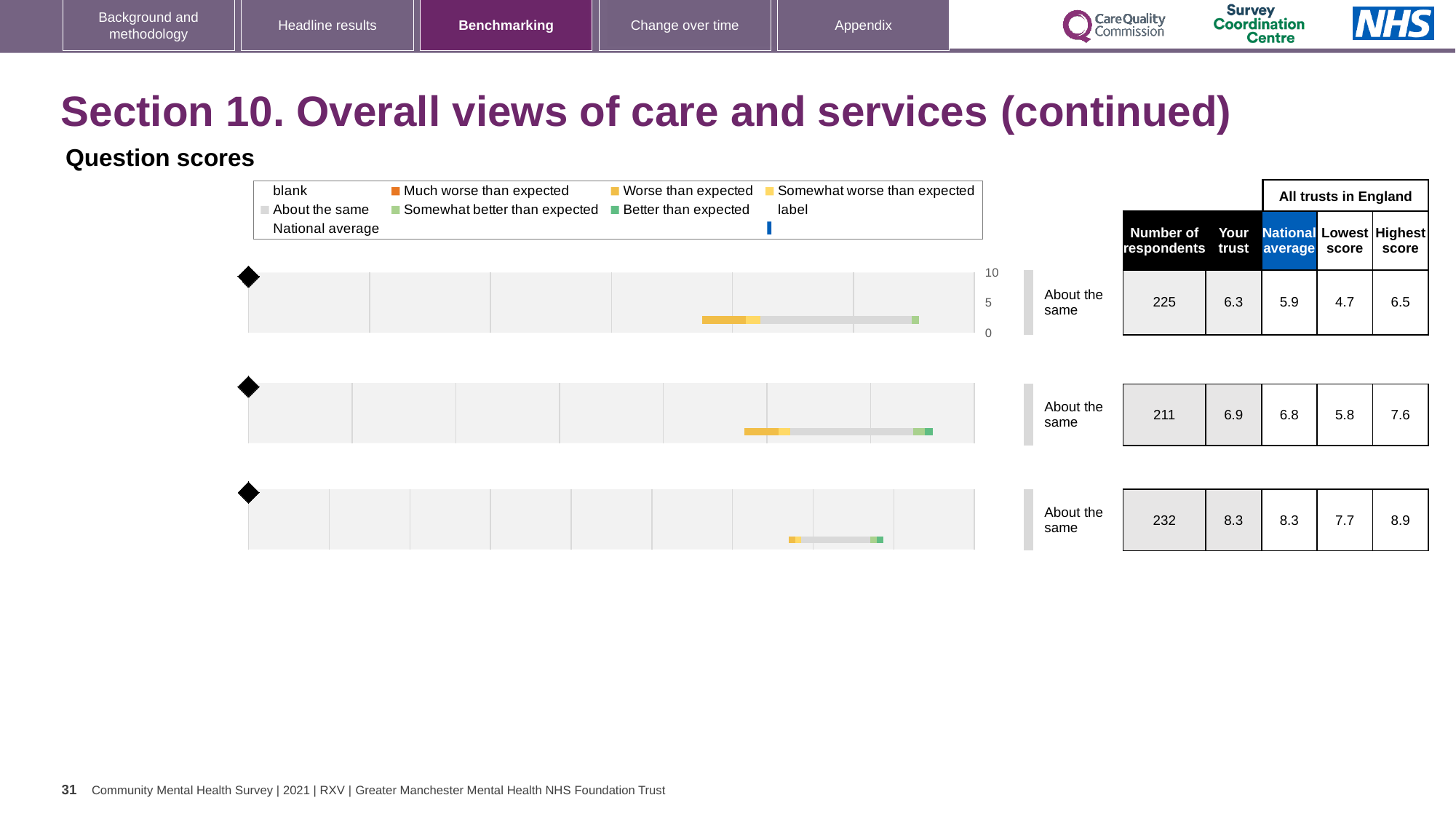
For the top chart, what is the number of respondents shown in the table? 225 For the middle chart, what is the lowest score among all trusts in England? 5.8 What benchmark category label is shown next to the bottom chart? About the same For the top chart, what is the difference between the highest score and the lowest score? 1.8 Which chart has the highest number of respondents: top, middle or bottom? bottom What is the maximum value shown on the score axis of the top chart? 10 For the bottom chart, what is the highest score among all trusts in England? 8.9 For the middle chart, which is larger: the 'Your trust' score or the national average? Your trust For the middle chart, what is the national average score? 6.8 How many benchmarking charts are shown on the slide? 3 What kind of chart is used for the question scores on this slide? bar chart For the top chart, what is the 'Your trust' score? 6.3